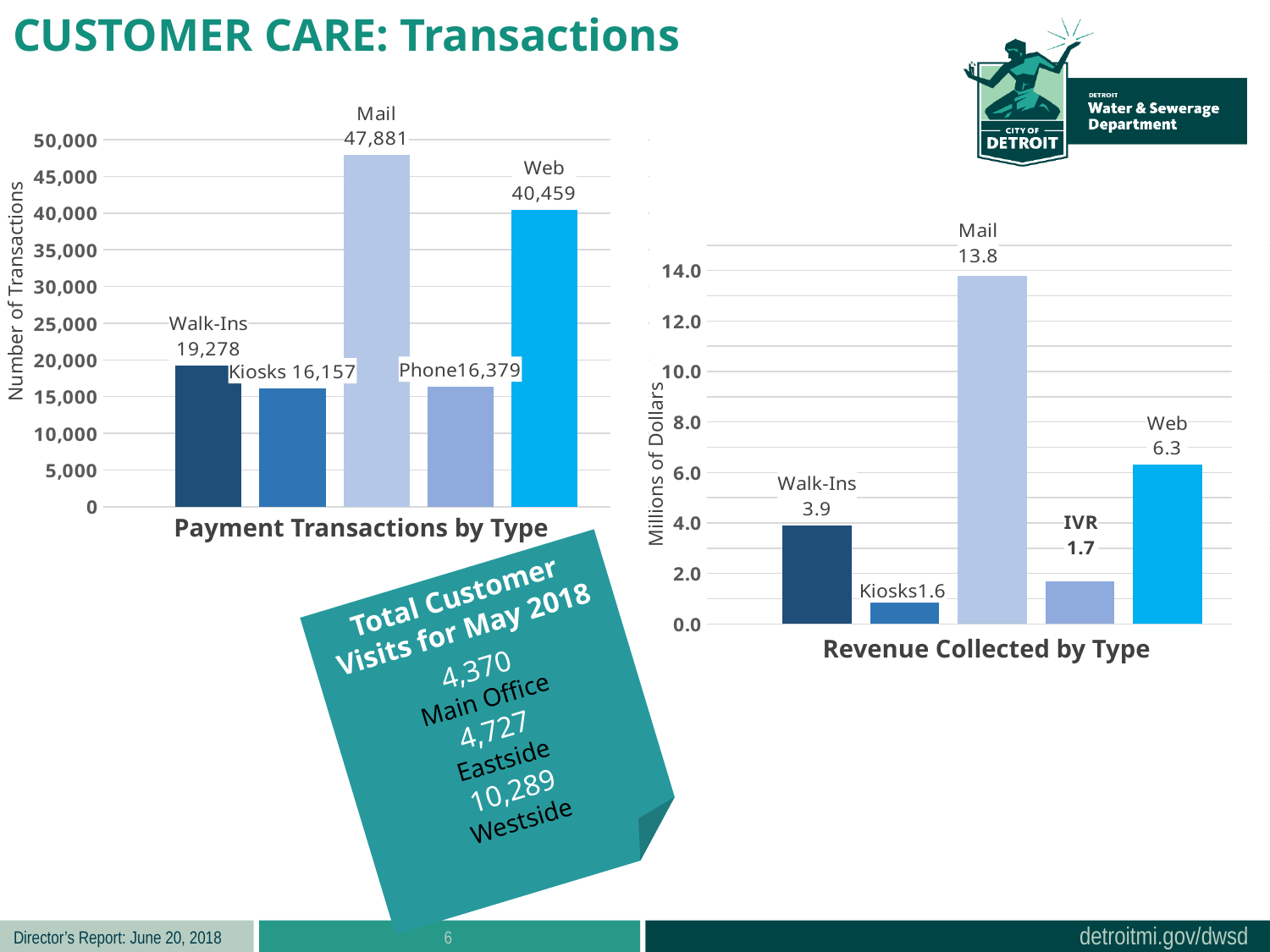
In the Revenue Collected by Type chart, how much revenue was collected via Web? 6.3 In the Payment Transactions by Type chart, which payment type has the highest number of transactions? Mail In the Payment Transactions by Type chart, what is the difference between Mail and Web transactions? 7,422 In the Revenue Collected by Type chart, which type collected the most revenue? Mail What type of chart is the Revenue Collected by Type chart? Bar chart In the Payment Transactions by Type chart, how many transactions were made by Mail? 47,881 In the Revenue Collected by Type chart, what is the difference between Mail and Walk-Ins revenue? 9.9 In the Revenue Collected by Type chart, how much revenue was collected by Mail? 13.8 In the Payment Transactions by Type chart, how many transactions were Walk-Ins? 19,278 In the Revenue Collected by Type chart, which is larger, the revenue from Walk-Ins or from Web? Web In the Payment Transactions by Type chart, how many payment types are shown? 5 In the Payment Transactions by Type chart, which payment type has the lowest number of transactions? Kiosks